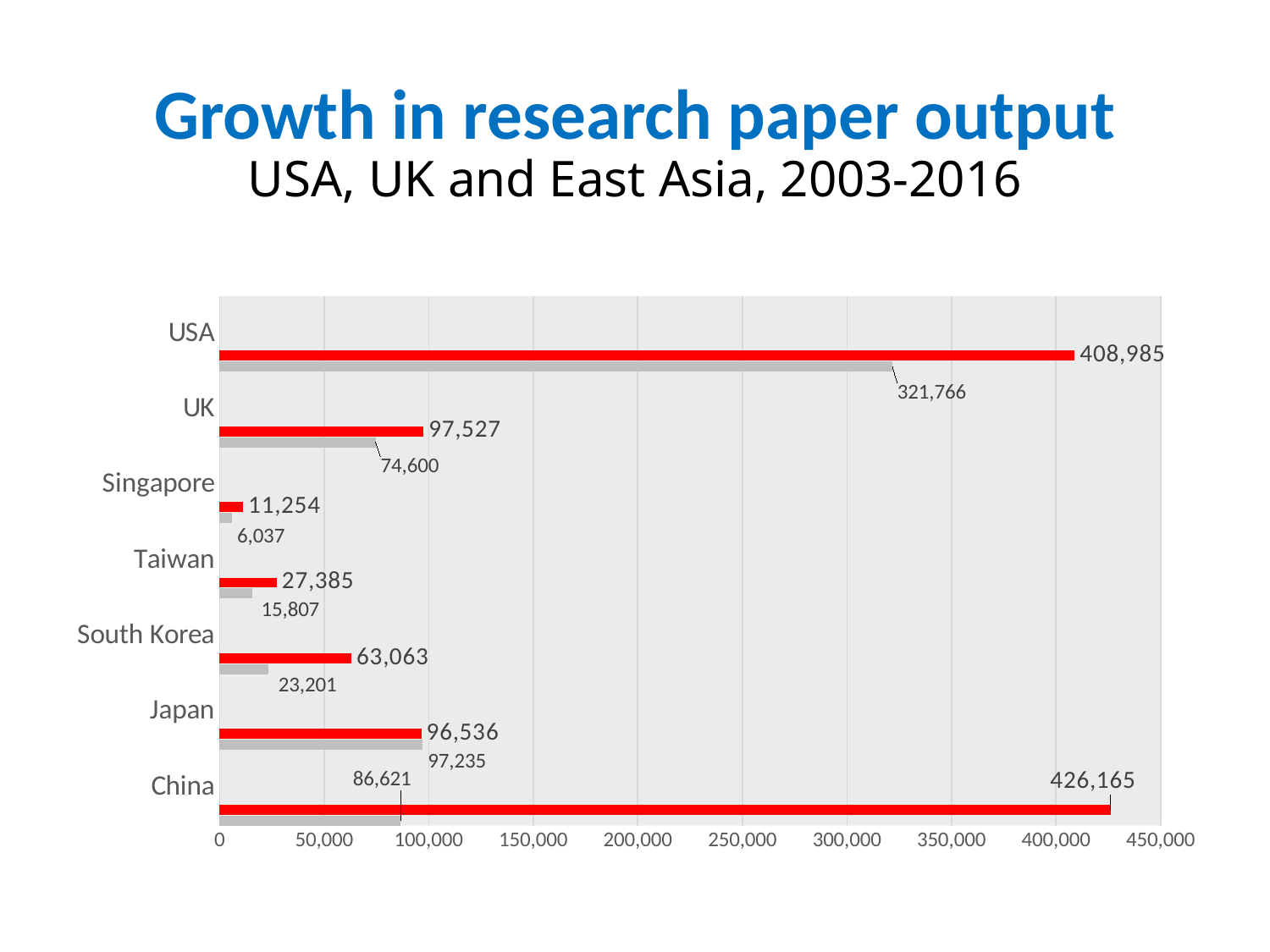
What is the title of the slide? Growth in research paper output How many countries are shown on the chart? 7 Is the grey bar value for the USA greater or less than 300,000? greater Which country has the highest red bar value? China What is the value of the red bar for South Korea? 63,063 What type of chart is shown on the slide? Bar chart What is the value of the grey bar for Taiwan? 15,807 What is the value of the red bar for the USA? 408,985 Which country has the lowest grey bar value? Singapore What is the value of the grey bar for the UK? 74,600 For Japan, which is larger: the red bar value or the grey bar value? The grey bar value (97,235) What is the difference between the red and grey bar values for China? 339,544